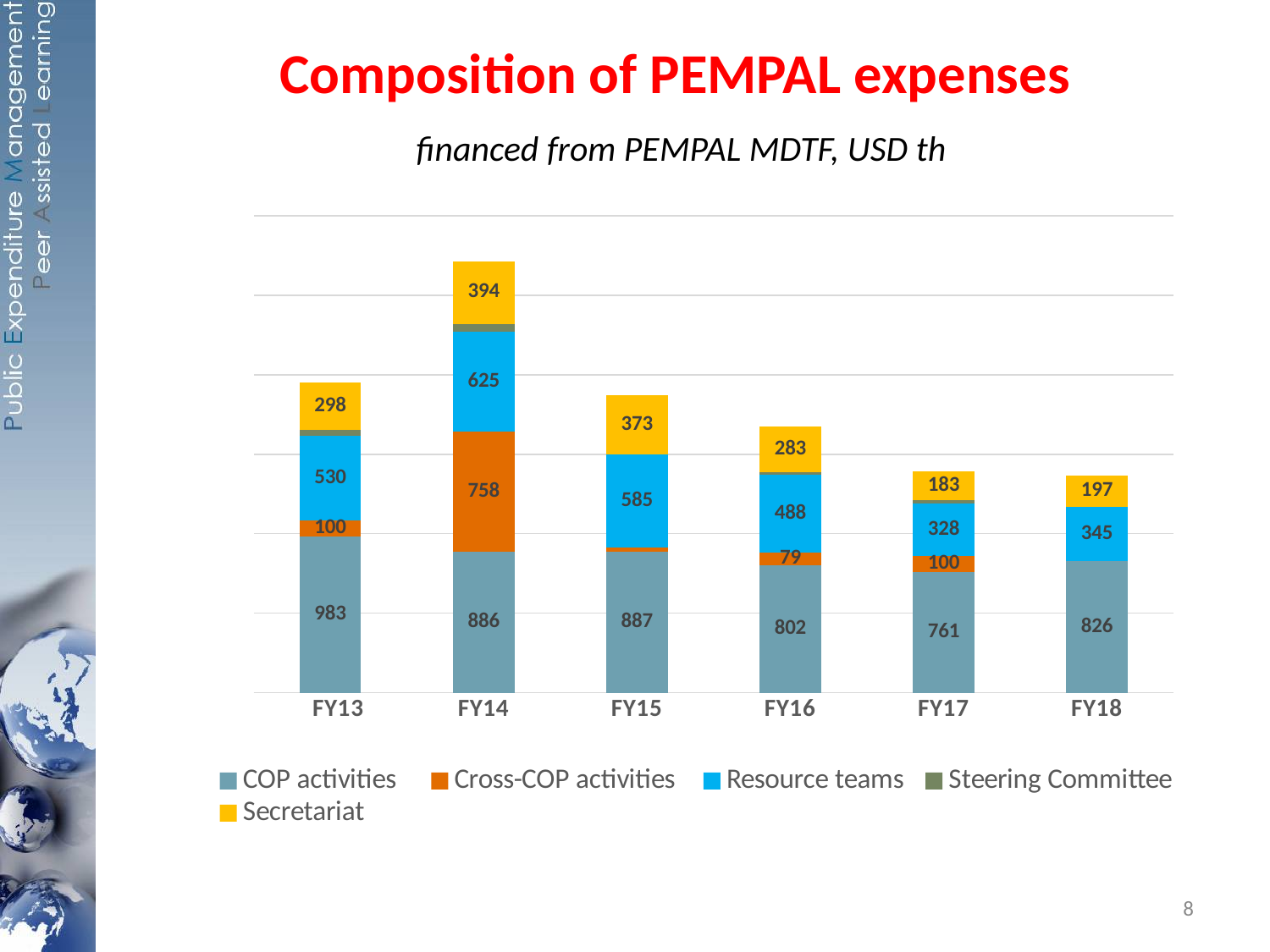
What type of chart is shown on the slide? Stacked bar chart What is the value of Cross-COP activities in FY14? 758 In which fiscal year is the COP activities value lowest? FY17 What is the value of Resource teams in FY16? 488 How many fiscal years are shown on the x axis? 6 In which fiscal year is the Secretariat value highest? FY14 What is the value of Secretariat in FY18? 197 What is the value of COP activities in FY13? 983 What is the difference between the Resource teams values in FY14 and FY17? 297 How many series does the legend list? 5 What is the subtitle shown under the chart title? financed from PEMPAL MDTF, USD th Which is larger, the Secretariat value in FY15 or in FY16? FY15